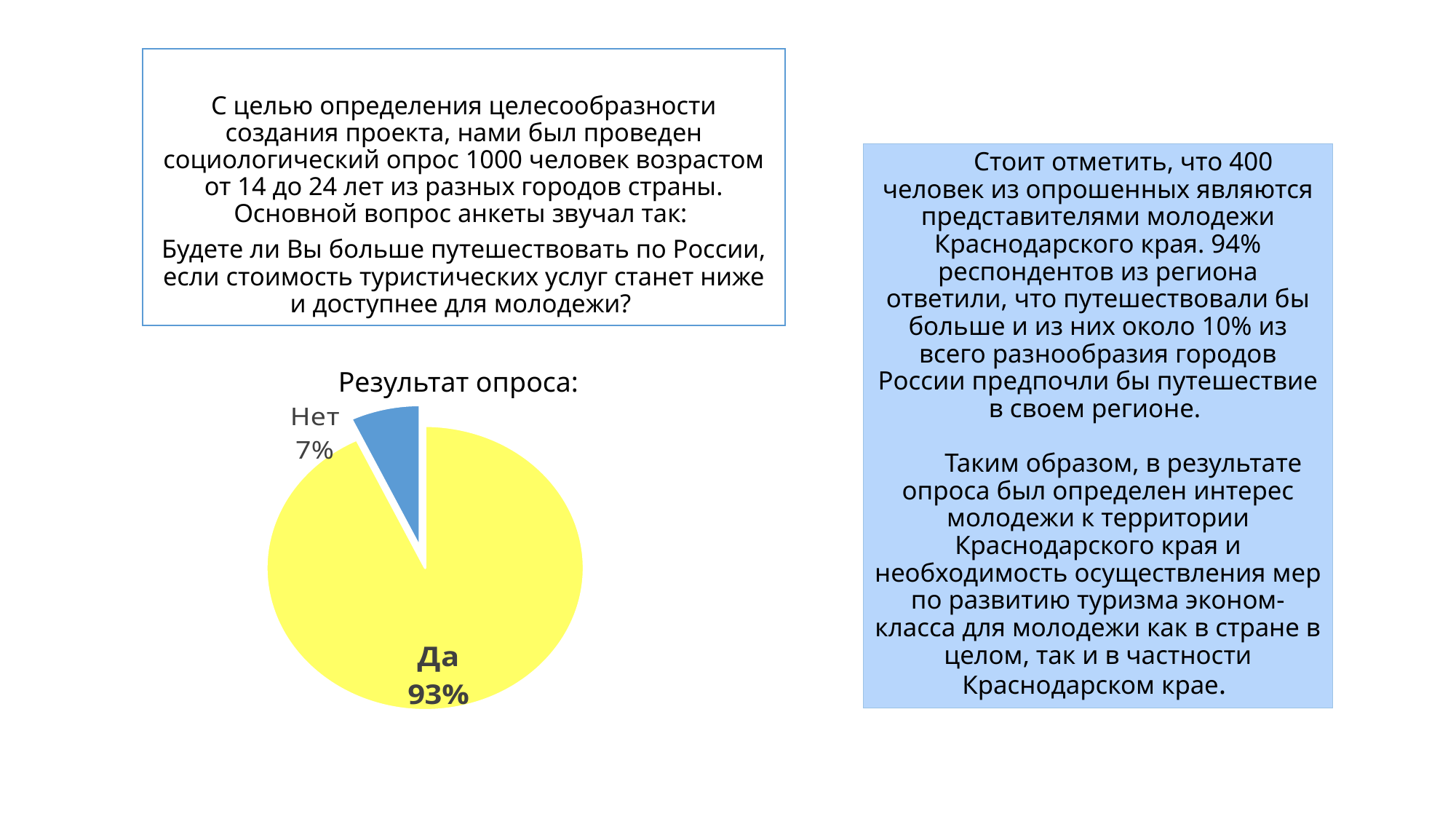
Which slice of the pie is the largest? Да What is the total of the two slice percentages shown on the pie chart? 100% Which is larger, the "Да" slice or the "Нет" slice? Да How many slices does the pie chart have? 2 What is the difference in percentage points between the "Да" and "Нет" slices? 86 What share of the pie does the "Нет" slice represent? 7% What kind of chart is shown on the slide? pie chart What is the title of the chart? Результат опроса: What colour is the "Да" slice? yellow Which slice of the pie is the smallest? Нет What share of the pie does the "Да" slice represent? 93%